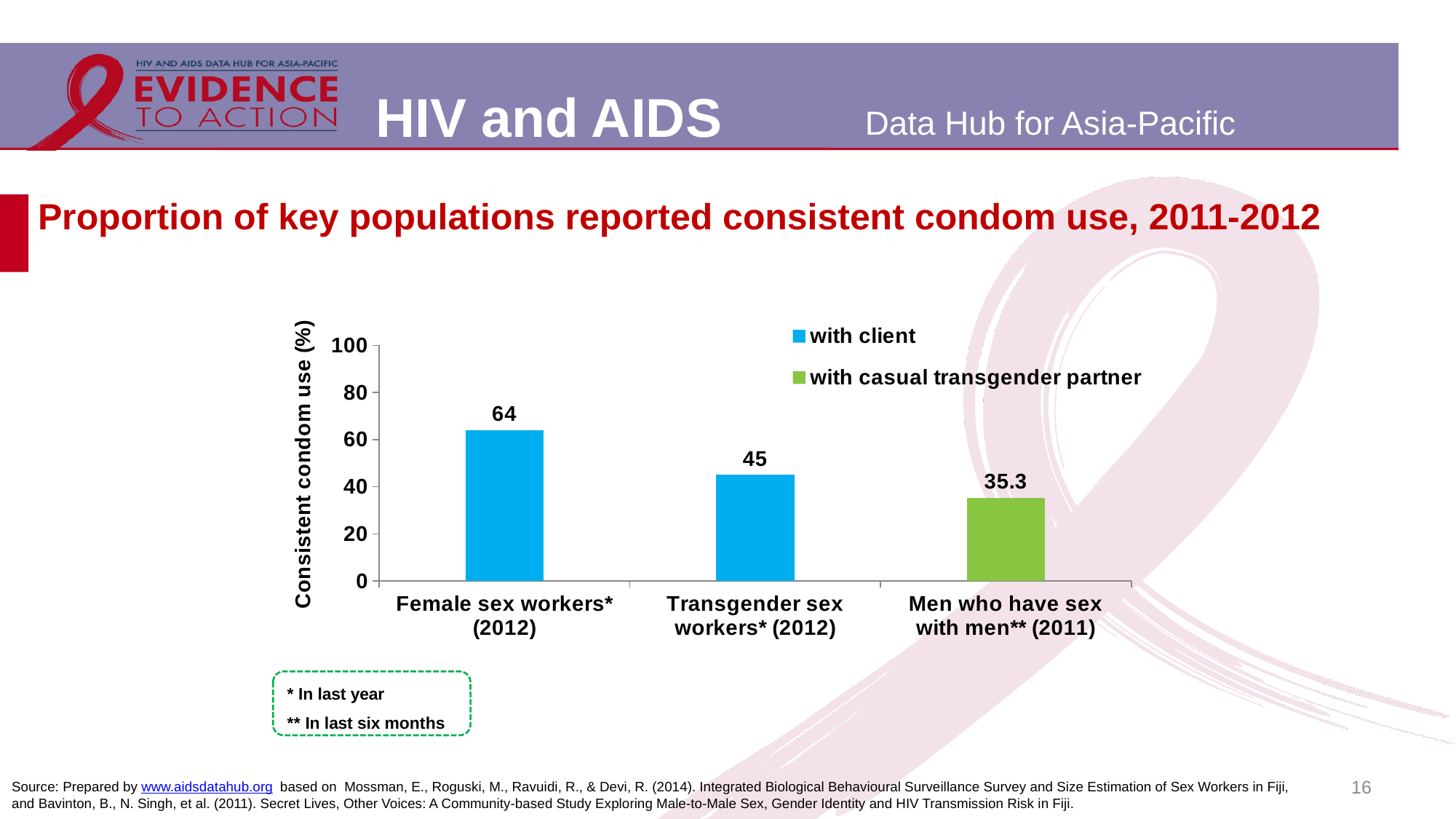
Which is larger: the value for Transgender sex workers* (2012) or Men who have sex with men** (2011)? Transgender sex workers* (2012) Which category has the lowest consistent condom use? Men who have sex with men** (2011) How many series does the legend list? 2 What is the difference between the values for Transgender sex workers* (2012) and Men who have sex with men** (2011)? 9.7 Which category has the highest consistent condom use? Female sex workers* (2012) What is the consistent condom use value for Men who have sex with men** (2011)? 35.3 What is the difference between the values for Female sex workers* (2012) and Transgender sex workers* (2012)? 19 Which legend series does the bar for Men who have sex with men** (2011) belong to? with casual transgender partner What is the consistent condom use value for Transgender sex workers* (2012)? 45 How many categories are shown on the x axis? 3 What is the consistent condom use value for Female sex workers* (2012)? 64 What kind of chart is shown on the slide? Bar chart